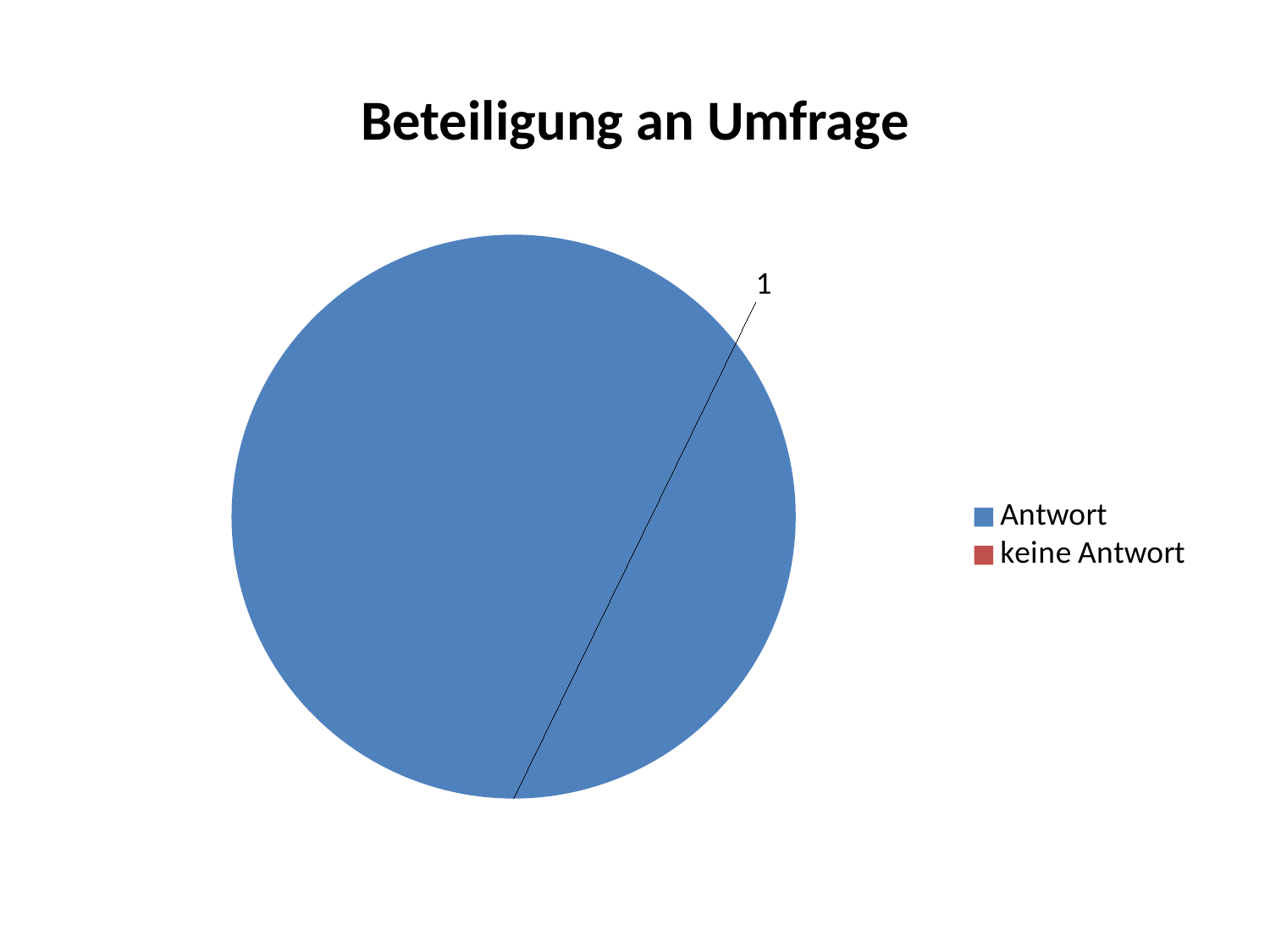
Which category has the smallest share of the pie? keine Antwort What colour represents Antwort in the legend? blue Which category takes up the largest share of the pie? Antwort What value is printed as the data label on the pie? 1 What is the title of the chart? Beteiligung an Umfrage Which is larger, the share for Antwort or the share for keine Antwort? Antwort How many entries does the legend list? 2 What kind of chart is shown on the slide? pie chart